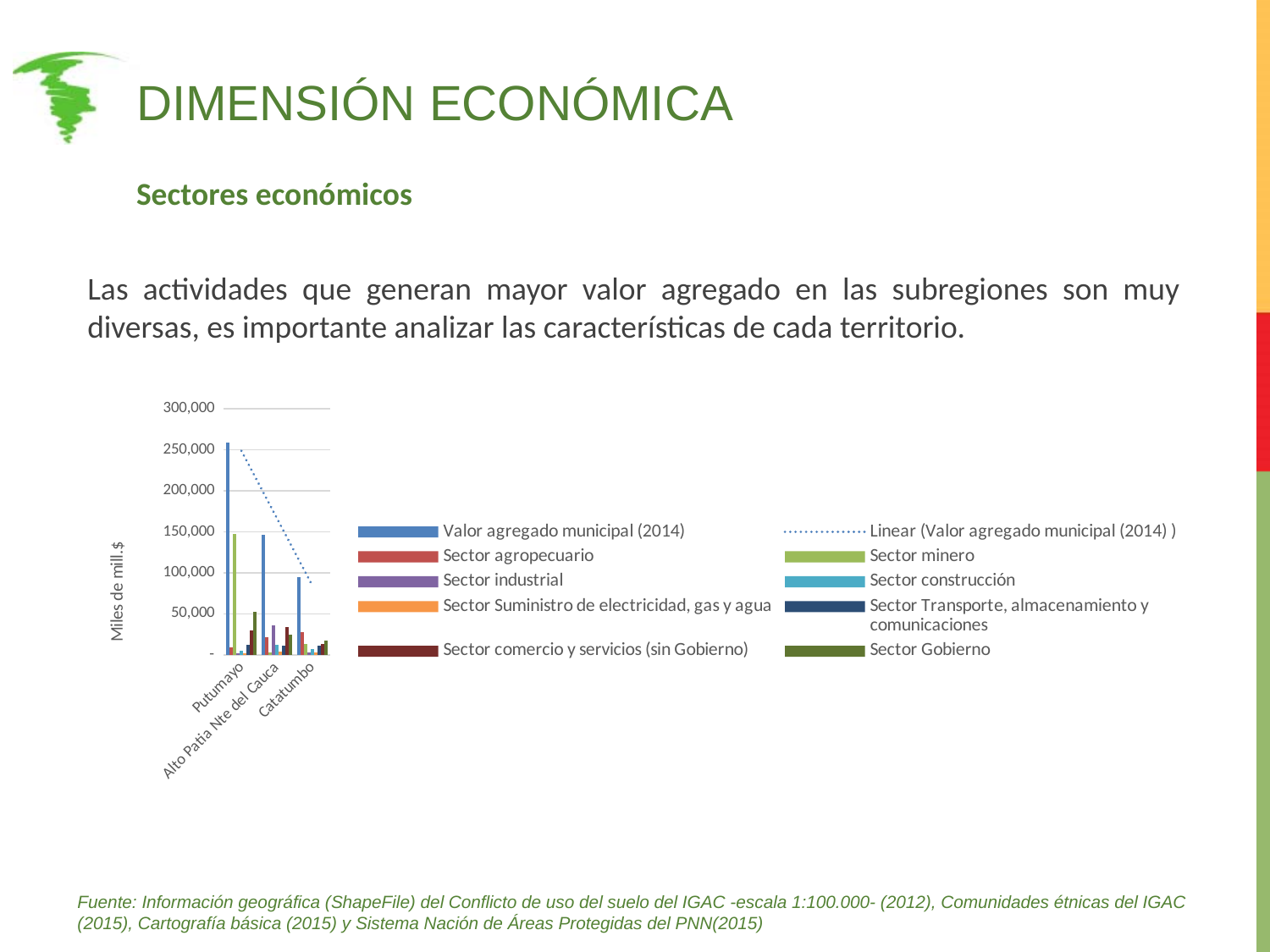
What is the label of the chart's vertical axis? Miles de mill.$ What kind of chart is shown on the slide? bar chart How many categories (subregions) are shown on the x axis of the chart? 3 Does the Valor agregado municipal (2014) rise or fall from Putumayo to Catatumbo along the x axis? fall Which subregion has the lowest value for Valor agregado municipal (2014)? Catatumbo Is the Sector minero value for Putumayo greater or less than 100,000? greater How many entries does the chart's legend list? 10 Which subregion has the highest value for Valor agregado municipal (2014)? Putumayo Is the Valor agregado municipal (2014) for Catatumbo greater or less than 150,000? less Which is larger, the Valor agregado municipal (2014) for Putumayo or for Catatumbo? Putumayo Is the Valor agregado municipal (2014) for Putumayo greater or less than 200,000? greater